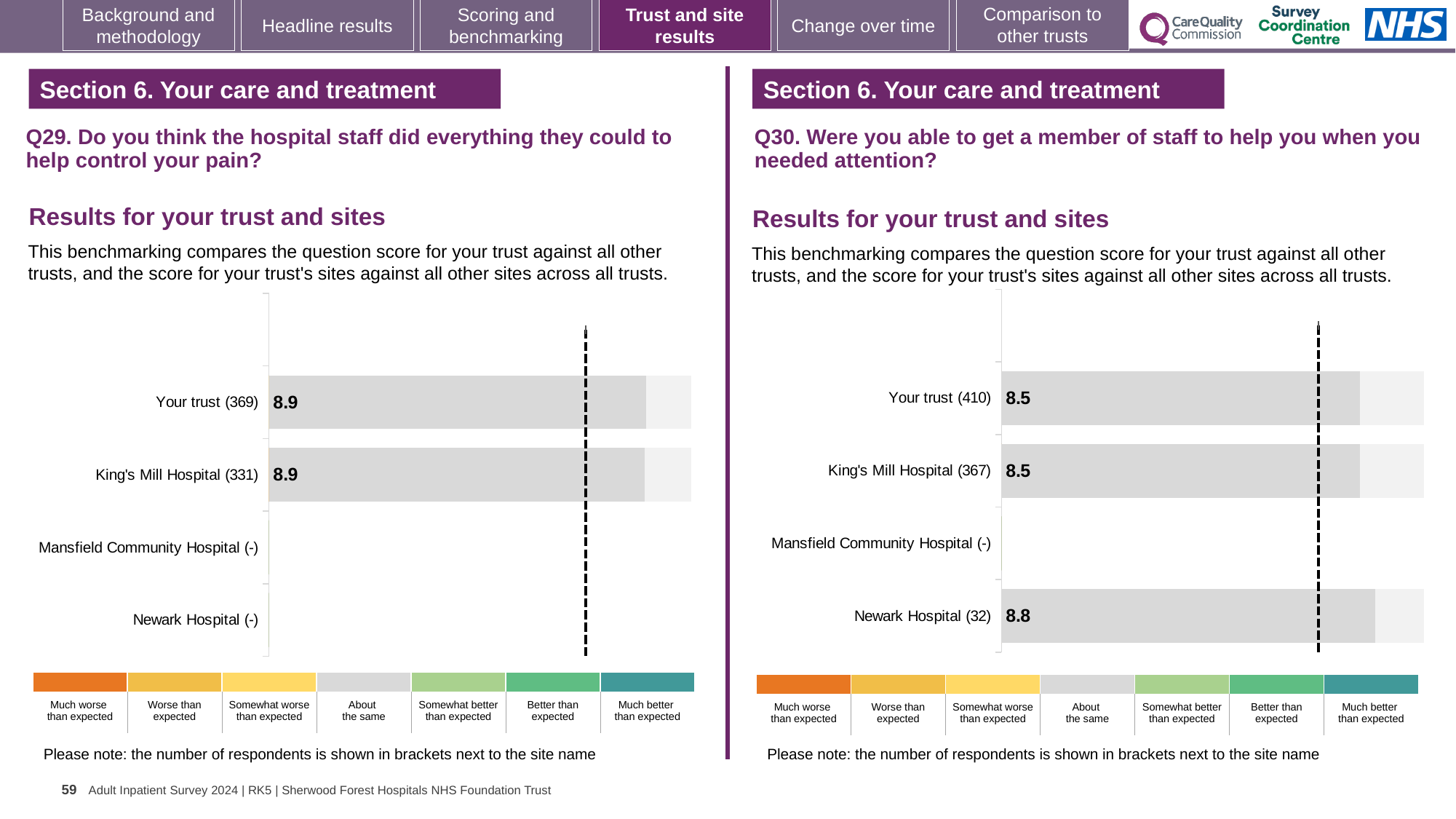
In the Q30 chart on the right, what is the score for Your trust (410)? 8.5 In the Q29 chart on the left, what is the score for King's Mill Hospital (331)? 8.9 In the Q29 chart on the left, what is the score for Your trust (369)? 8.9 In the Q30 chart on the right, how many respondents are shown in brackets for Newark Hospital? 32 In the Q30 chart on the right, which is larger: the score for Newark Hospital or the score for King's Mill Hospital? Newark Hospital In the Q30 chart on the right, what is the difference between the Newark Hospital score and the Your trust score? 0.3 What type of chart is used in the Q29 chart on the left? Bar chart How many site/trust categories are listed on the y axis of the Q29 chart on the left? 4 In the Q29 chart on the left, how many respondents are shown in brackets for King's Mill Hospital? 331 In the Q30 chart on the right, which site has the highest score? Newark Hospital In the Q30 chart on the right, what is the score for Newark Hospital (32)? 8.8 In the Q30 chart on the right, what is the score for King's Mill Hospital (367)? 8.5